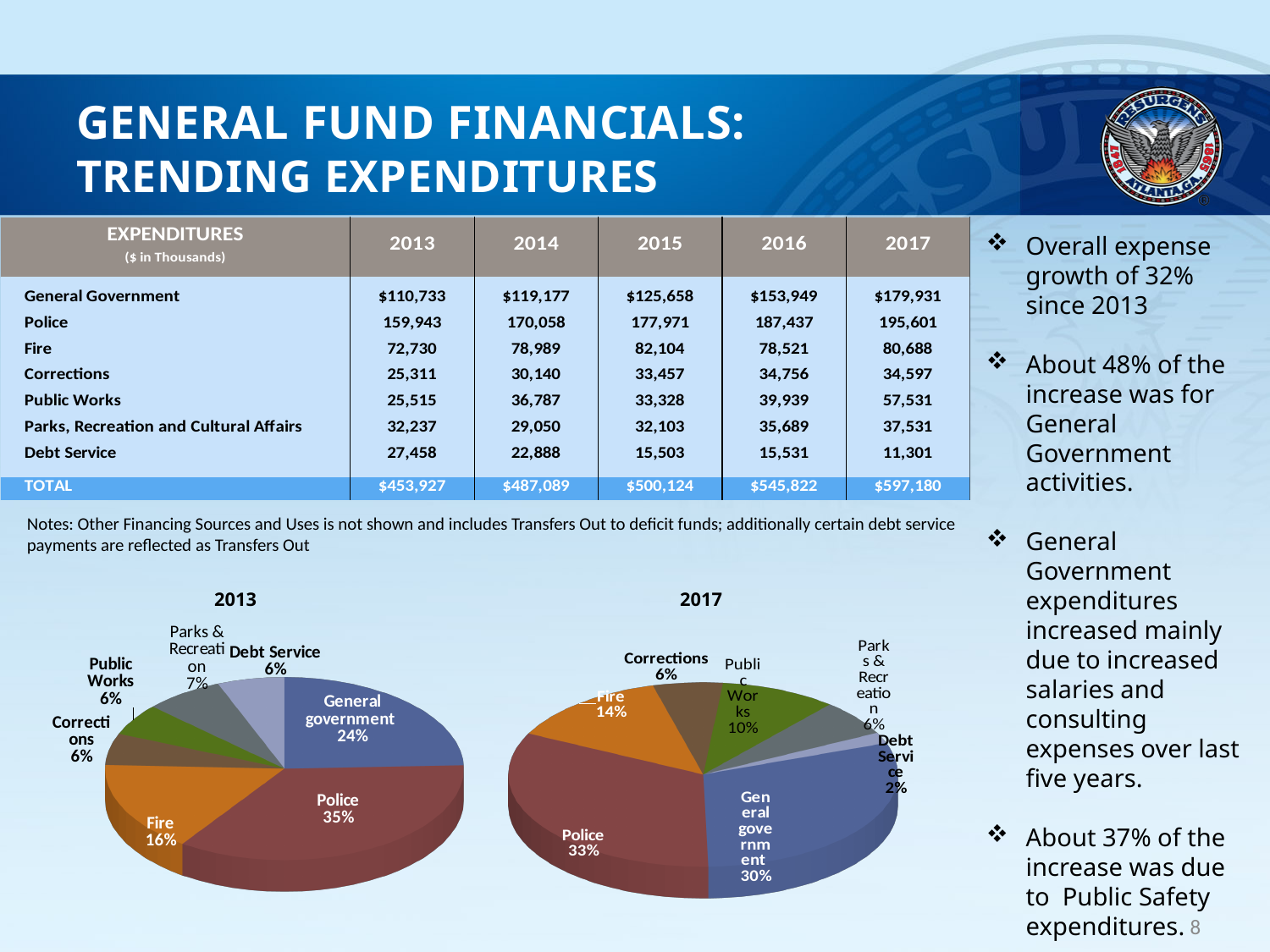
In the 2013 pie chart, which category has the largest share? Police In the 2017 pie chart, which category has the smallest share? Debt Service In the 2017 pie chart, what share of expenditures is Debt Service? 2% In the 2013 pie chart, what share of expenditures is Police? 35% In the 2013 pie chart, what share of expenditures is Fire? 16% What is the title of the pie chart on the left? 2013 What is the difference between the Police share in the 2013 pie chart and the Police share in the 2017 pie chart? 2% In the 2017 pie chart, which is larger: the Fire share or the Corrections share? Fire What type of chart is used to show the 2013 expenditure breakdown? pie chart How many slices does the 2017 pie chart have? 7